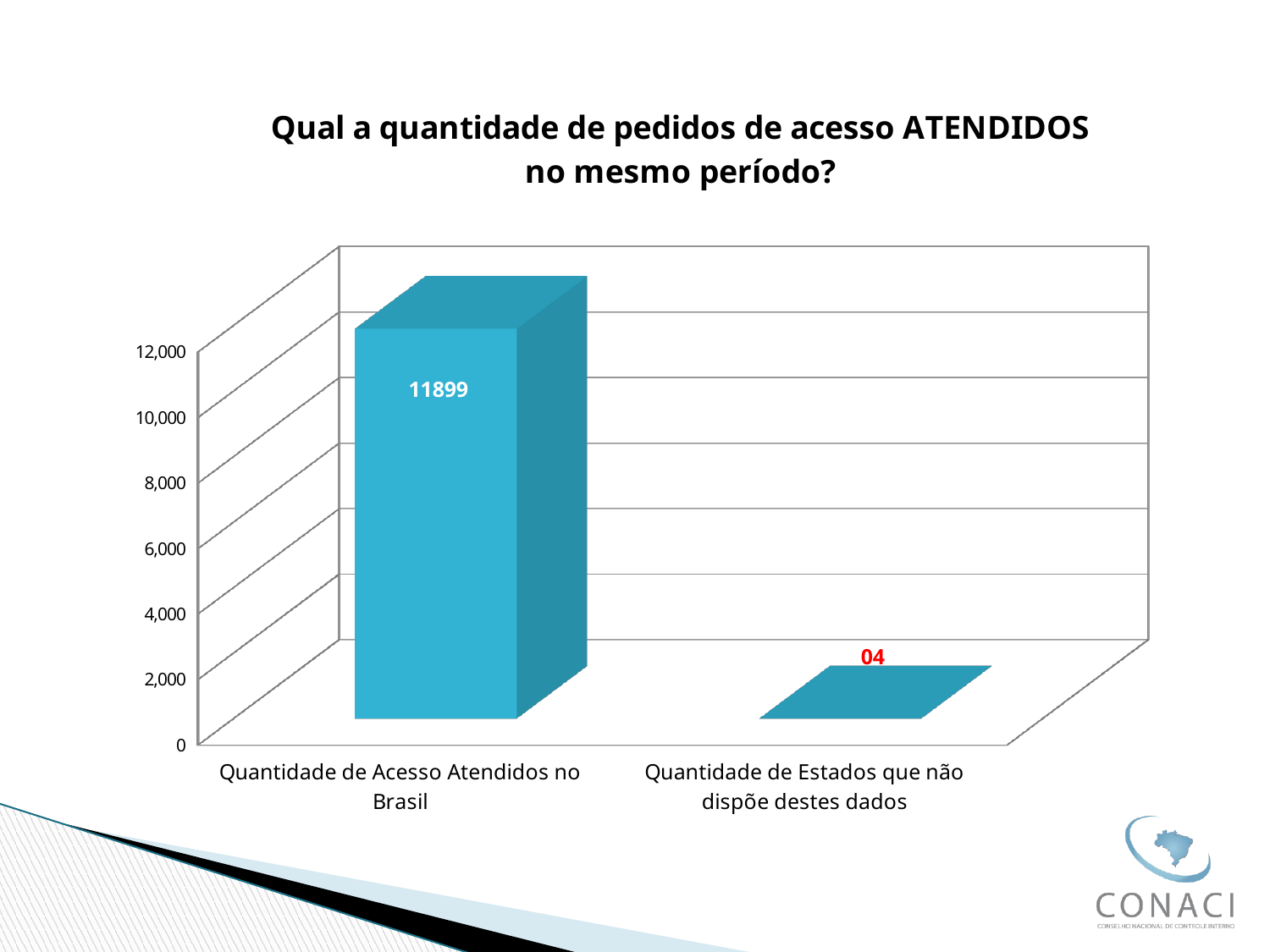
What is the value for "Quantidade de Estados que não dispõe destes dados"? 04 How many categories are shown on the chart? 2 What is the highest value labelled on the vertical axis? 12,000 Which category has the highest value? Quantidade de Acesso Atendidos no Brasil What kind of chart is shown on the slide? bar chart Which category has the lowest value? Quantidade de Estados que não dispõe destes dados Which is larger: the value for "Quantidade de Acesso Atendidos no Brasil" or the value for "Quantidade de Estados que não dispõe destes dados"? Quantidade de Acesso Atendidos no Brasil What is the value for "Quantidade de Acesso Atendidos no Brasil"? 11899 Is the value for "Quantidade de Estados que não dispõe destes dados" greater or less than 2,000? less What is the difference between the value for "Quantidade de Acesso Atendidos no Brasil" and the value for "Quantidade de Estados que não dispõe destes dados"? 11895 Is the value for "Quantidade de Acesso Atendidos no Brasil" greater or less than 10,000? greater What is the title of the chart? Qual a quantidade de pedidos de acesso ATENDIDOS no mesmo período?